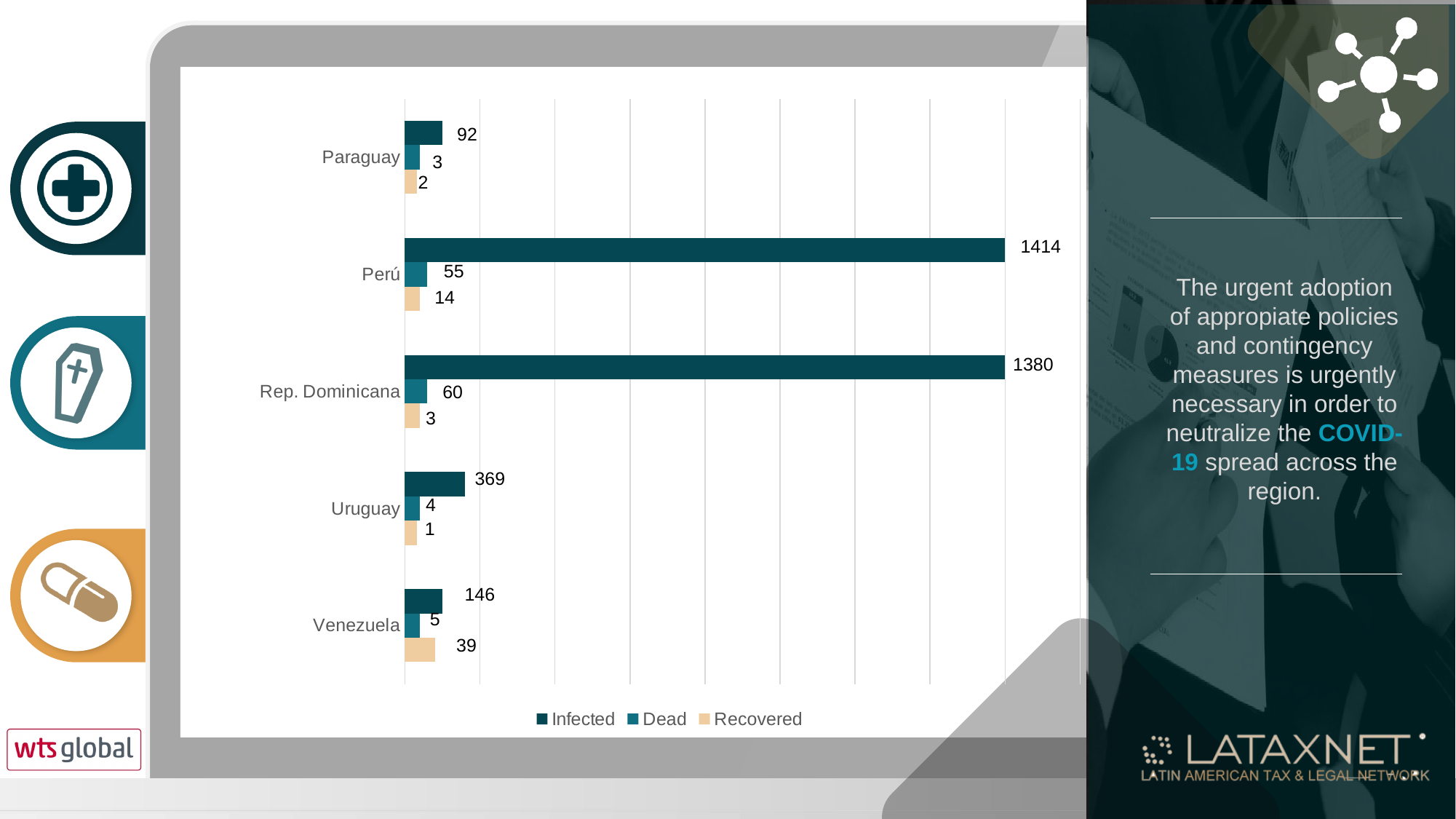
What is the difference between the Dead values for Rep. Dominicana and Perú? 5 What kind of chart is shown on the slide? Bar chart Which is larger, the Infected value for Uruguay or for Venezuela? Uruguay How many countries are shown on the chart? 5 How many series does the legend list? 3 What is the Infected value for Perú? 1414 What are the three series listed in the legend? Infected, Dead, Recovered Which country has the lowest Infected value? Paraguay What is the Recovered value for Venezuela? 39 What is the Dead value for Rep. Dominicana? 60 What is the difference between the Infected values for Perú and Rep. Dominicana? 34 Which country has the highest Infected value? Perú